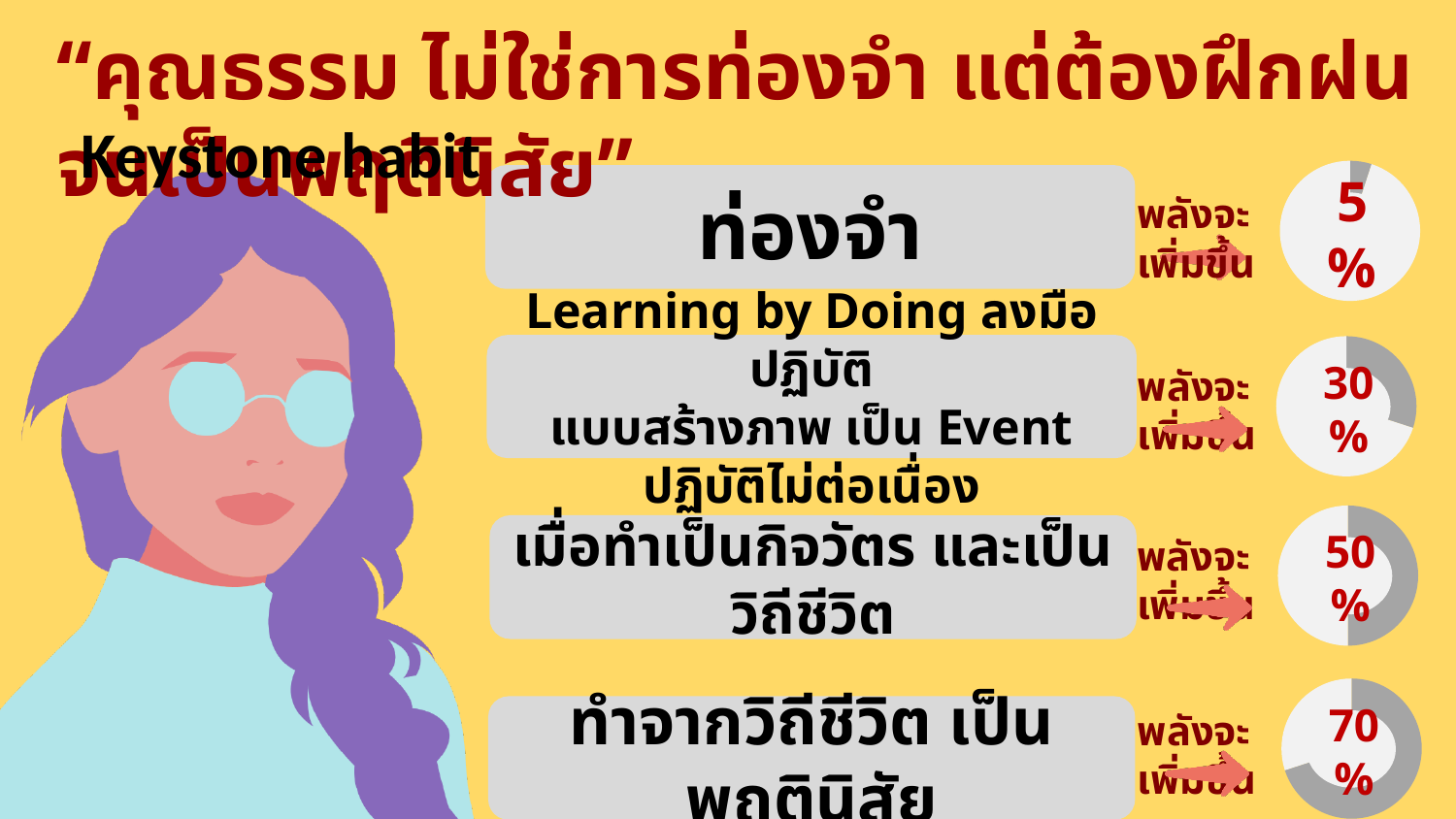
What is the difference between the percentage in the bottom doughnut chart and the percentage in the top doughnut chart? 65% What percentage is shown in the third doughnut chart from the top, next to "เมื่อทำเป็นกิจวัตร และเป็นวิถีชีวิต"? 50% What percentage is shown in the bottom doughnut chart next to "ทำจากวิถีชีวิต เป็นพฤตินิสัย"? 70% What percentage is shown in the second doughnut chart from the top, next to "Learning by Doing"? 30% How many doughnut charts are shown on the right side of the slide? 4 Which of the four doughnut charts on the right shows the lowest percentage? The top one (ท่องจำ), 5% Which is larger: the percentage in the second doughnut chart (30%) or the third doughnut chart (50%)? The third doughnut chart, 50% Which of the four doughnut charts on the right shows the highest percentage? The bottom one (ทำจากวิถีชีวิต เป็นพฤตินิสัย), 70% What percentage is shown in the top doughnut chart next to "ท่องจำ"? 5% Do the percentages in the doughnut charts increase or decrease going from the top chart to the bottom chart? Increase What kind of chart is used to show the percentages on the right side of the slide? Doughnut chart What is the difference between the percentages in the third doughnut chart (50%) and the second doughnut chart (30%)? 20%